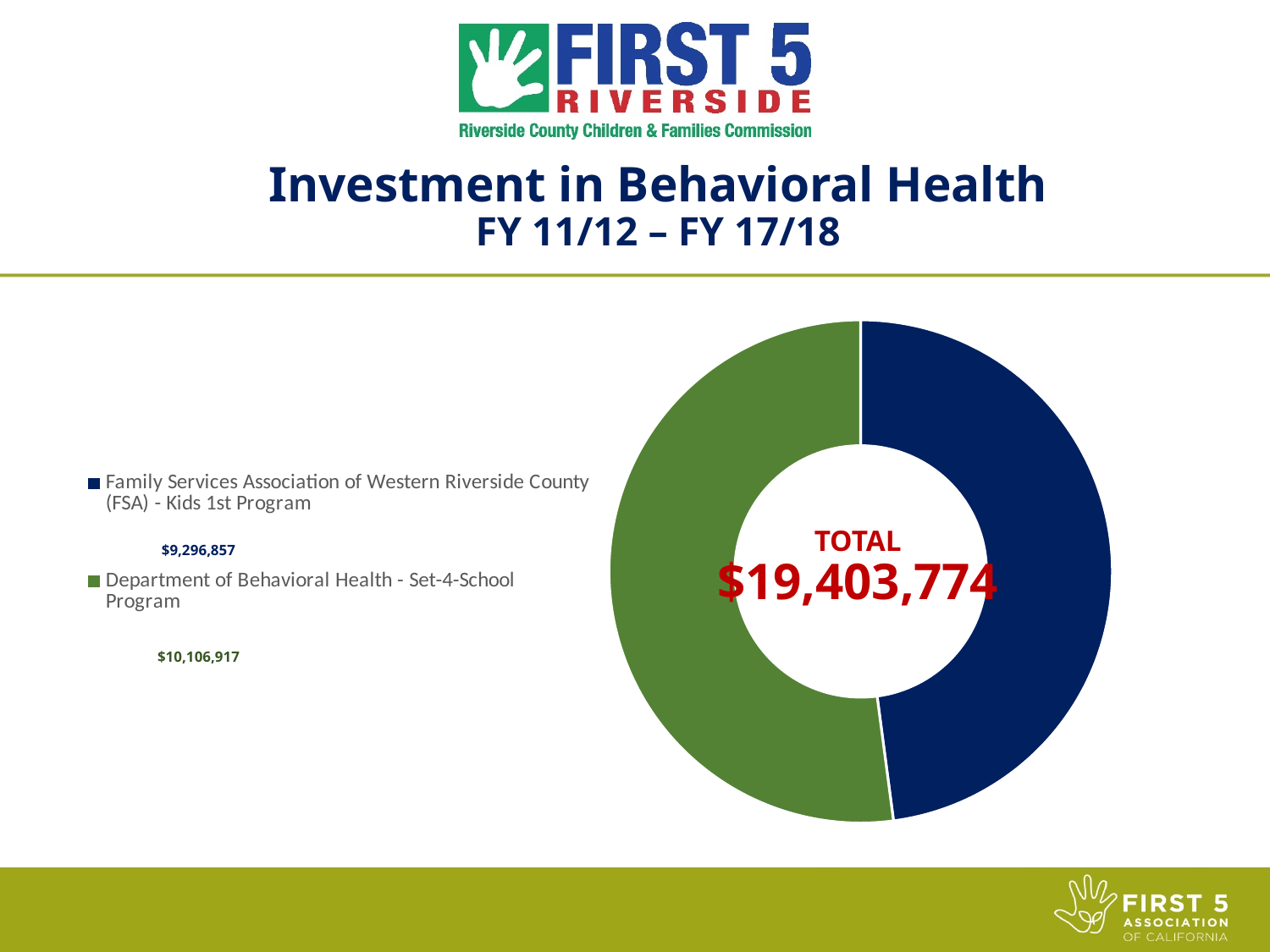
How many programs are shown in the chart? 2 Is the investment in the Kids 1st Program larger or smaller than the investment in the Set-4-School Program? smaller What is the value for the Family Services Association of Western Riverside County (FSA) - Kids 1st Program? $9,296,857 What colour represents the Department of Behavioral Health - Set-4-School Program? green Which program received the larger investment? Department of Behavioral Health - Set-4-School Program What fiscal year range does the slide title cover? FY 11/12 – FY 17/18 What is the total investment shown in the center of the chart? $19,403,774 How many entries does the legend list? 2 What kind of chart is shown on the slide? doughnut (pie) chart What is the difference between the Set-4-School Program investment and the Kids 1st Program investment? $810,060 Which program received the smaller investment? Family Services Association of Western Riverside County (FSA) - Kids 1st Program What is the value for the Department of Behavioral Health - Set-4-School Program? $10,106,917